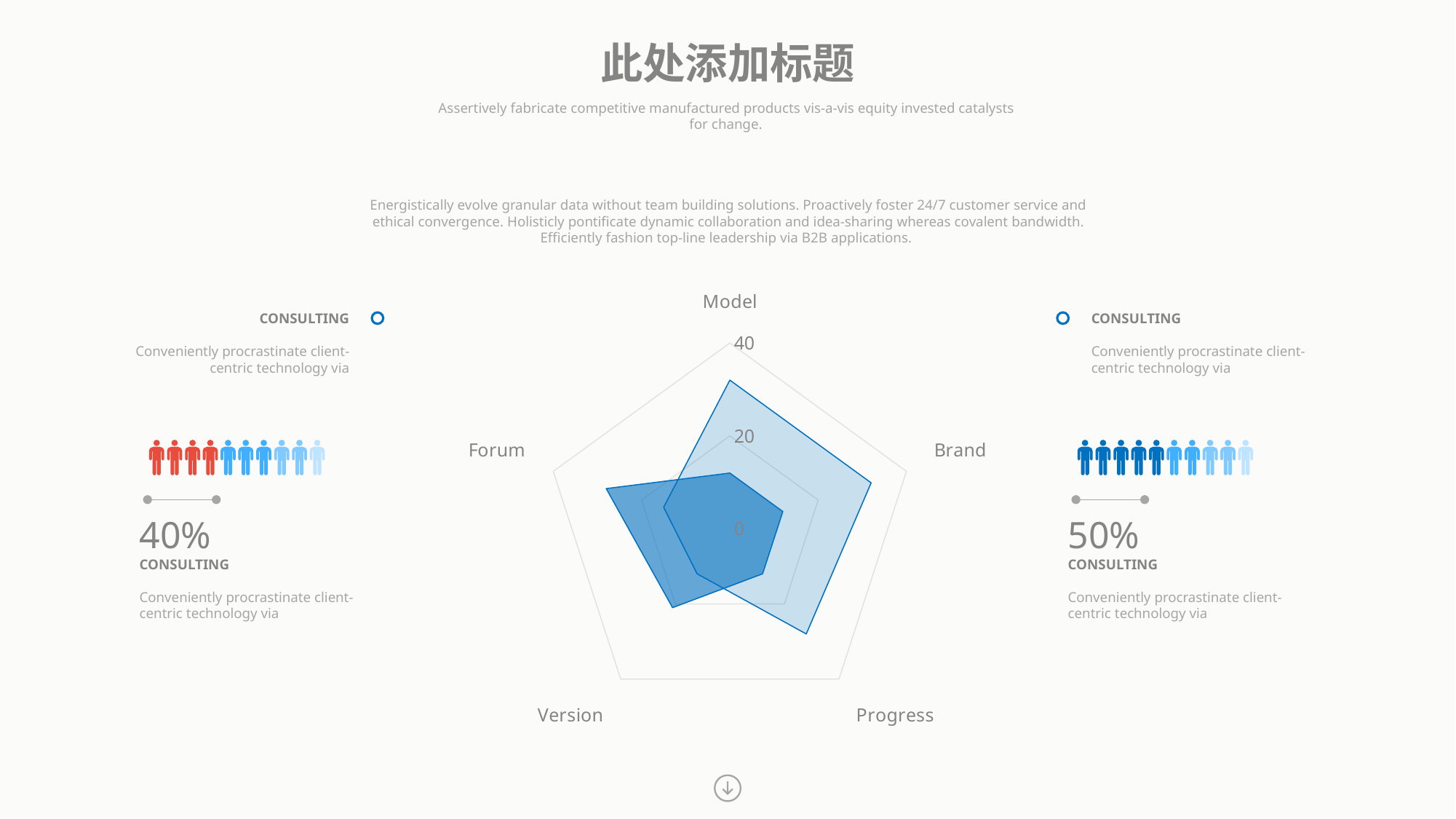
How many categories (axes) does the radar chart have? 5 What is the highest value shown on the radar chart's axis scale? 40 Is the value for Forum in the lighter blue series greater or less than 20? less Is the value for Model in the lighter blue series greater or less than 40? less Is the value for Model in the lighter blue series greater or less than 20? greater Which category label appears at the top of the radar chart? Model What kind of chart is shown on the slide? radar chart Which series has the larger value for Brand, the lighter blue series or the darker blue series? the lighter blue series